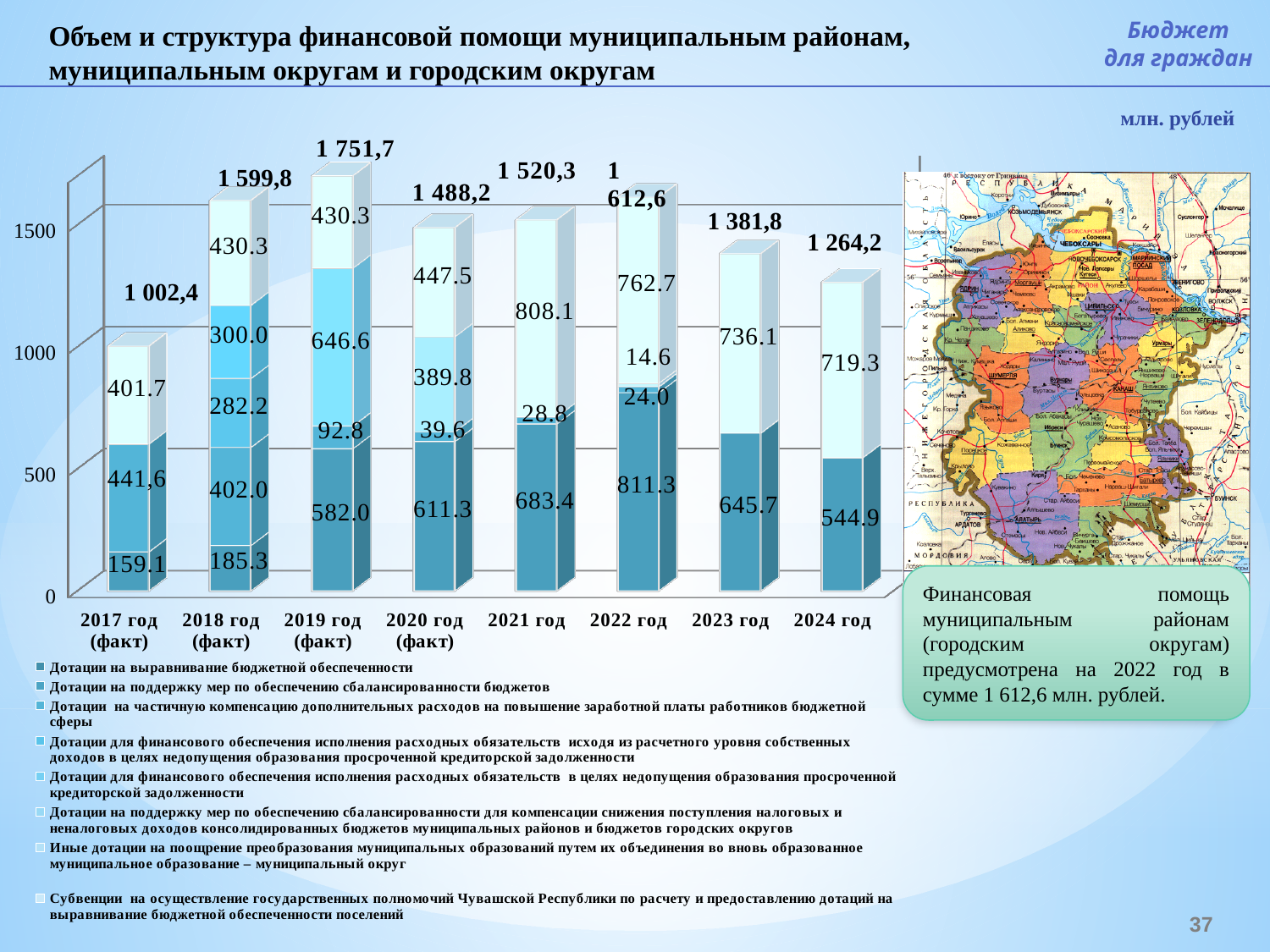
Which year has the lowest total financial aid? 2017 год (факт) Which total is larger, 2020 год (факт) or 2021 год? 2021 год What is the total financial aid shown above the bar for 2019 год (факт)? 1 751,7 Do the totals rise or fall from 2022 год to 2024 год? Fall What is the difference between the totals for 2022 год and 2023 год? 230,8 What unit of measurement is stated in the top right of the chart? млн. рублей What is the value of the bottom (darkest) segment of the bar for 2022 год? 811.3 How many series does the legend list? 8 How many years (categories) are shown on the x axis? 8 Which year has the highest total financial aid? 2019 год (факт) What is the total value labelled above the bar for 2024 год? 1 264,2 What kind of chart is shown on the slide? Stacked bar chart